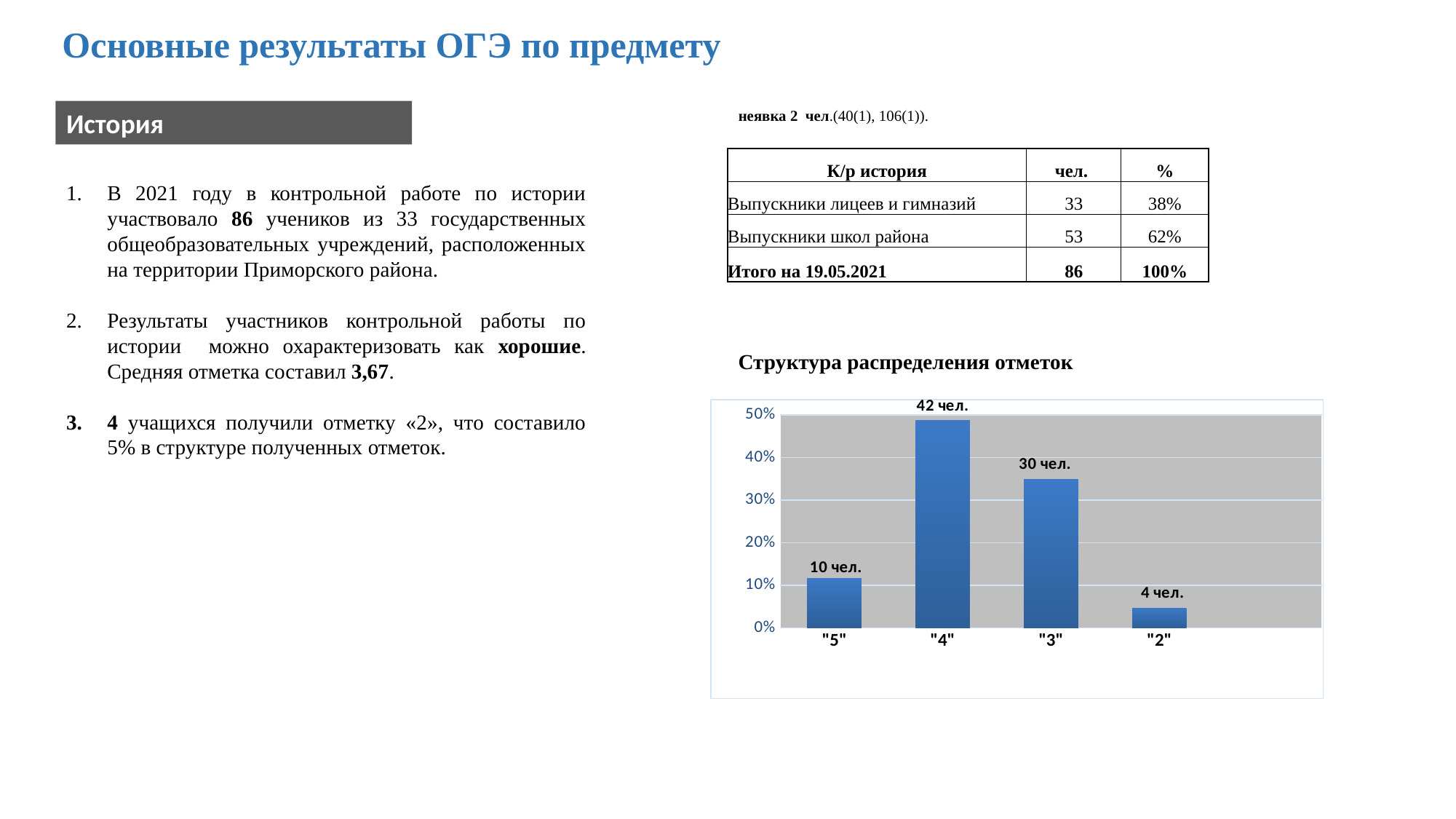
Which grade has the tallest bar in the chart "Структура распределения отметок"? "4" What is the data label on the bar for "5" in the chart "Структура распределения отметок"? 10 чел. What is the data label on the bar for "2" in the chart "Структура распределения отметок"? 4 чел. What is the data label on the bar for "3" in the chart "Структура распределения отметок"? 30 чел. How many grade categories are shown in the chart "Структура распределения отметок"? 4 What is the data label on the bar for "4" in the chart "Структура распределения отметок"? 42 чел. Which grade has the shortest bar in the chart "Структура распределения отметок"? "2" What type of chart is "Структура распределения отметок"? bar chart In the chart "Структура распределения отметок", is the value for "5" greater or less than 20%? less In the chart "Структура распределения отметок", how many more people received "4" than "3" according to the data labels? 12 чел. In the chart "Структура распределения отметок", is the value for "4" greater or less than 40%? greater In the chart "Структура распределения отметок", which bar is taller: "5" or "3"? "3"